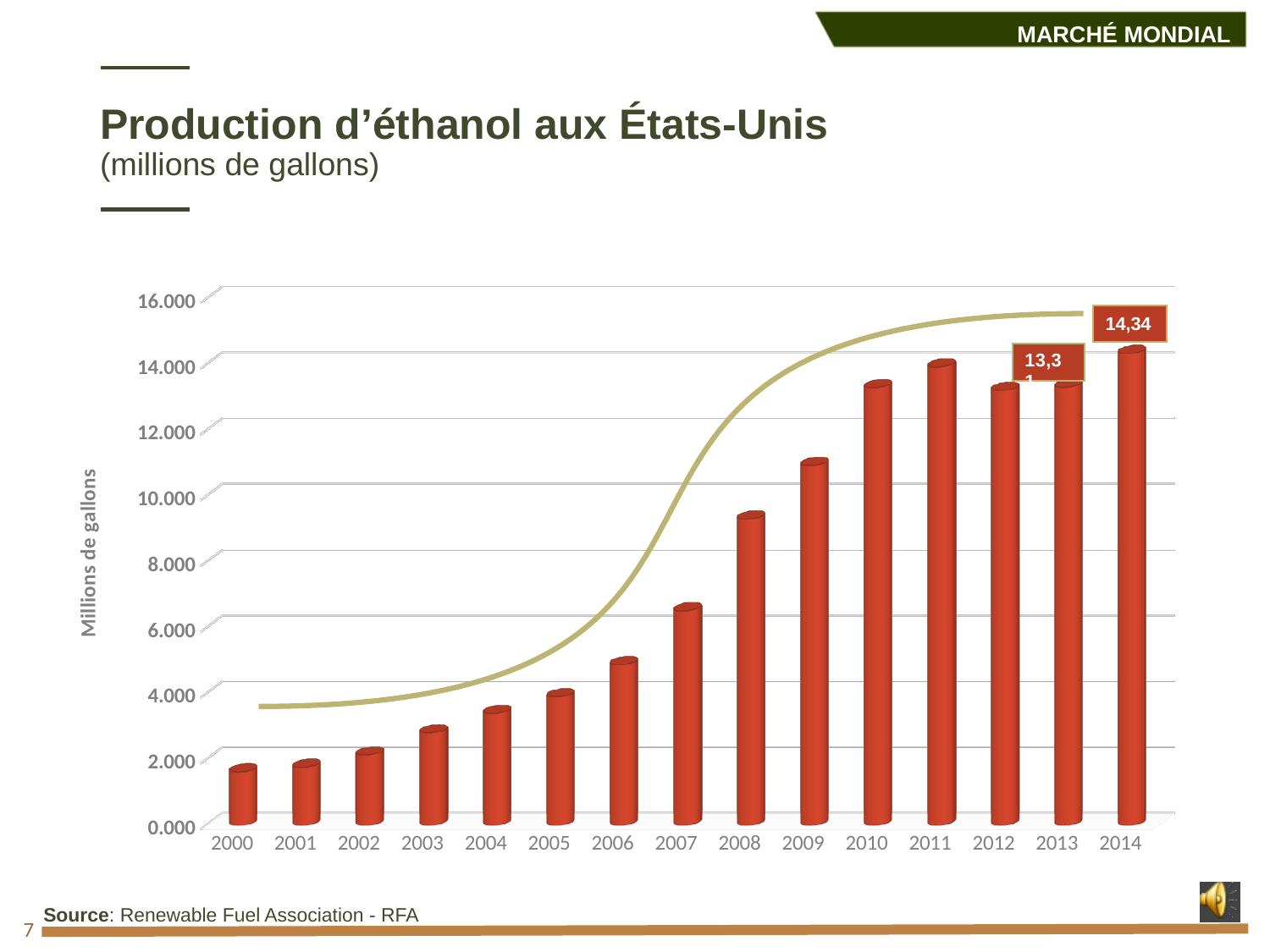
Which year has the highest ethanol production in the chart? 2014 Which year has the larger value, 2011 or 2012? 2011 What kind of chart is shown on the slide? Bar chart How many years are shown on the x axis of the chart? 15 Is the value for 2010 greater or less than 12.000? greater Is the value for 2009 greater or less than 10.000? greater What is the data label shown for 2014? 14,34 Is the value for 2008 greater or less than 10.000? less Which year has the lowest ethanol production in the chart? 2000 What is the label on the vertical axis of the chart? Millions de gallons Do the values generally rise or fall from 2000 to 2011? Rise